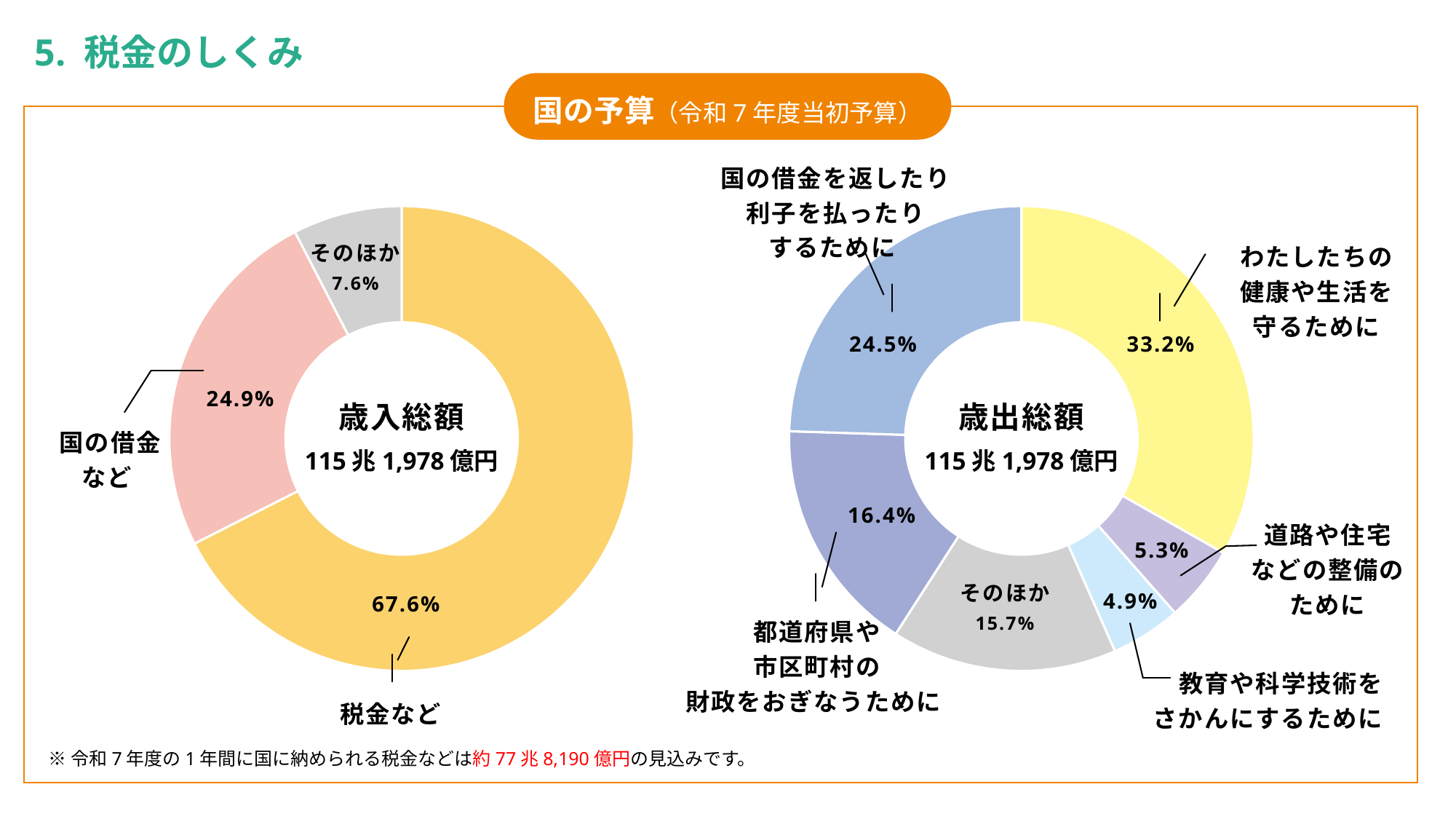
What kind of chart is used for 歳出総額? Donut (pie) chart In the 歳入総額 chart, how many categories are shown? 3 In the 歳出総額 chart, what share is labelled for 教育や科学技術をさかんにするために? 4.9% In the 歳入総額 chart, which category has the smallest share? そのほか In the 歳出総額 chart, what share is labelled for わたしたちの健康や生活を守るために? 33.2% In the 歳入総額 chart, what share is labelled for 国の借金など? 24.9% In the 歳出総額 chart, how many categories are shown? 6 What total amount is printed in the centre of the 歳出総額 chart? 115兆1,978億円 In the 歳出総額 chart, which category has the largest share? わたしたちの健康や生活を守るために In the 歳入総額 chart, what is the difference between the shares for 税金など and 国の借金など? 42.7% In the 歳入総額 chart, what share is labelled for 税金など? 67.6% In the 歳出総額 chart, which is larger: the share for 都道府県や市区町村の財政をおぎなうために or the share for そのほか? 都道府県や市区町村の財政をおぎなうために